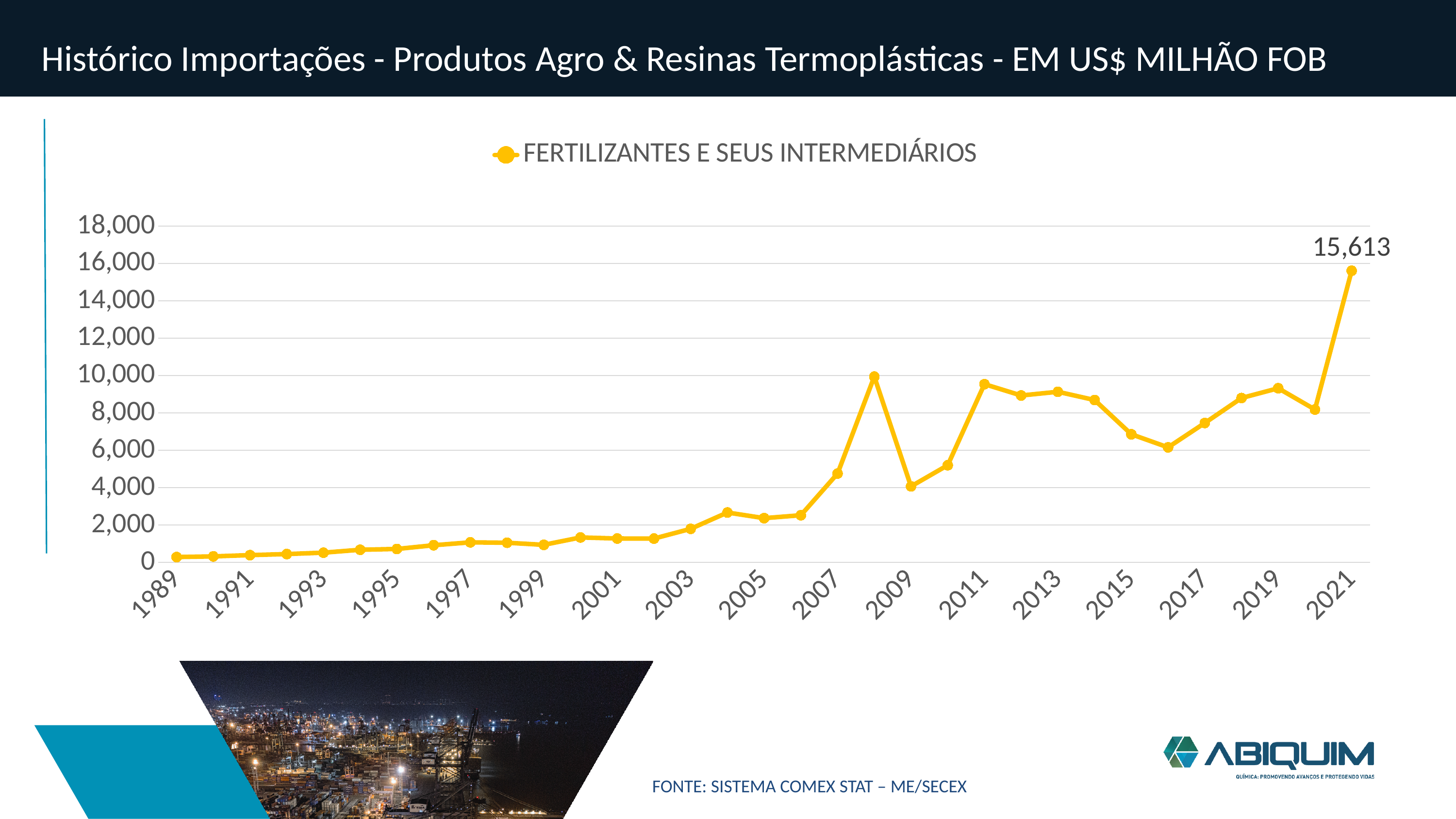
What is the value for 2021 for FERTILIZANTES E SEUS INTERMEDIÁRIOS? 15,613 Is the value for 2016 greater or less than 8,000? less Is the value for 2008 greater or less than 8,000? greater How many data points are plotted on the line? 33 Does the value rise or fall from 2020 to 2021? rise Is the value for 2009 greater or less than 6,000? less What type of chart is shown on the slide? line chart What is the name of the series shown in the legend? FERTILIZANTES E SEUS INTERMEDIÁRIOS How many series does the legend list? 1 Which year has the highest value for FERTILIZANTES E SEUS INTERMEDIÁRIOS? 2021 Which year has the larger value, 2008 or 2009? 2008 Which year has the larger value, 2020 or 2021? 2021